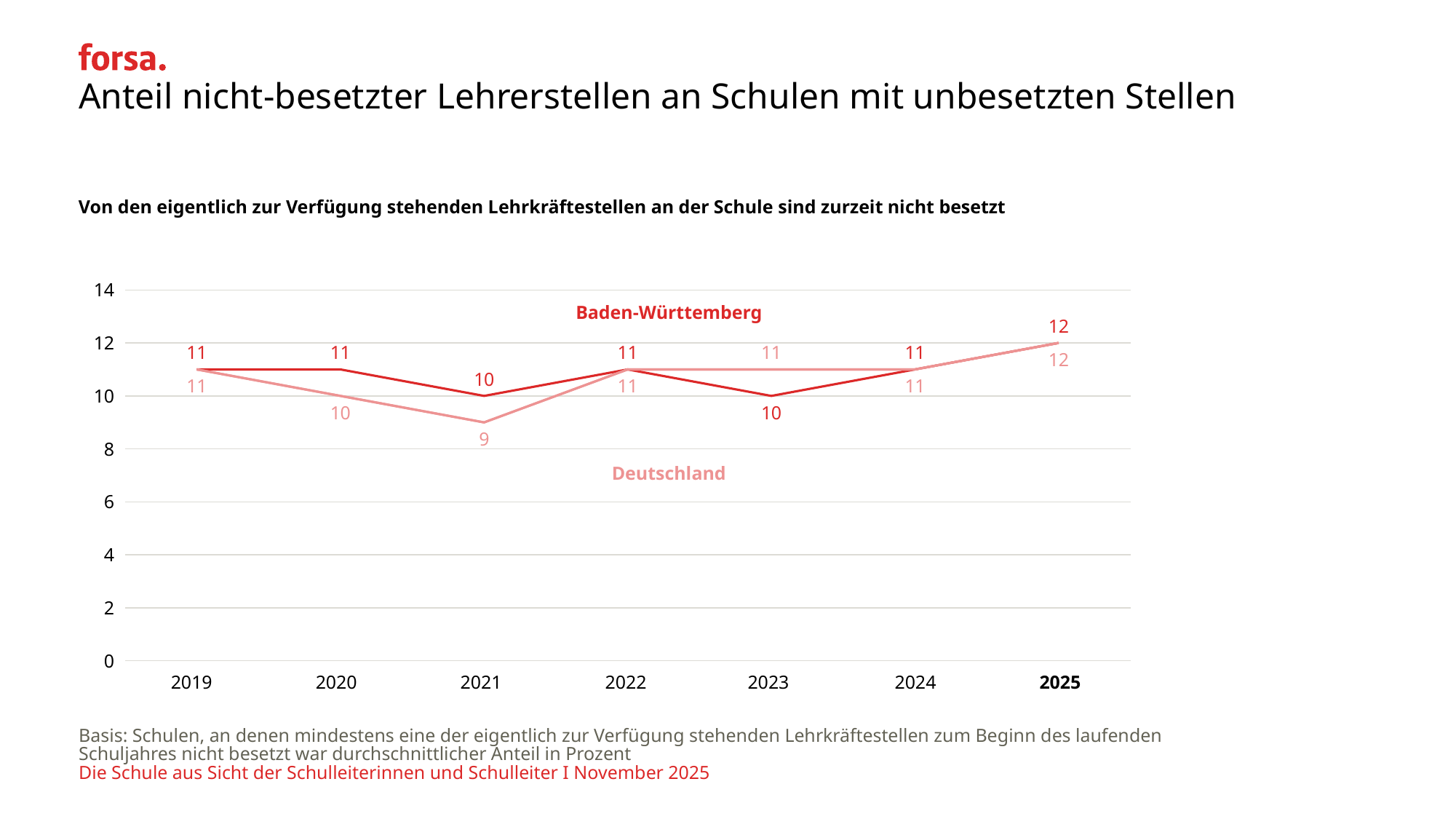
Which series is drawn in the darker red line? Baden-Württemberg What is the value for Baden-Württemberg in 2021? 10 In which year is the value for Deutschland lowest? 2021 What is the difference between the Baden-Württemberg and Deutschland values in 2021? 1 What kind of chart is shown on the slide? line chart Which series has the larger value in 2023, Baden-Württemberg or Deutschland? Deutschland In which year is the value for Baden-Württemberg highest? 2025 How many series are plotted in the chart? 2 What is the value for Baden-Württemberg in 2025? 12 What is the value for Deutschland in 2021? 9 How many years are shown on the x axis of the chart? 7 What is the value for Deutschland in 2020? 10